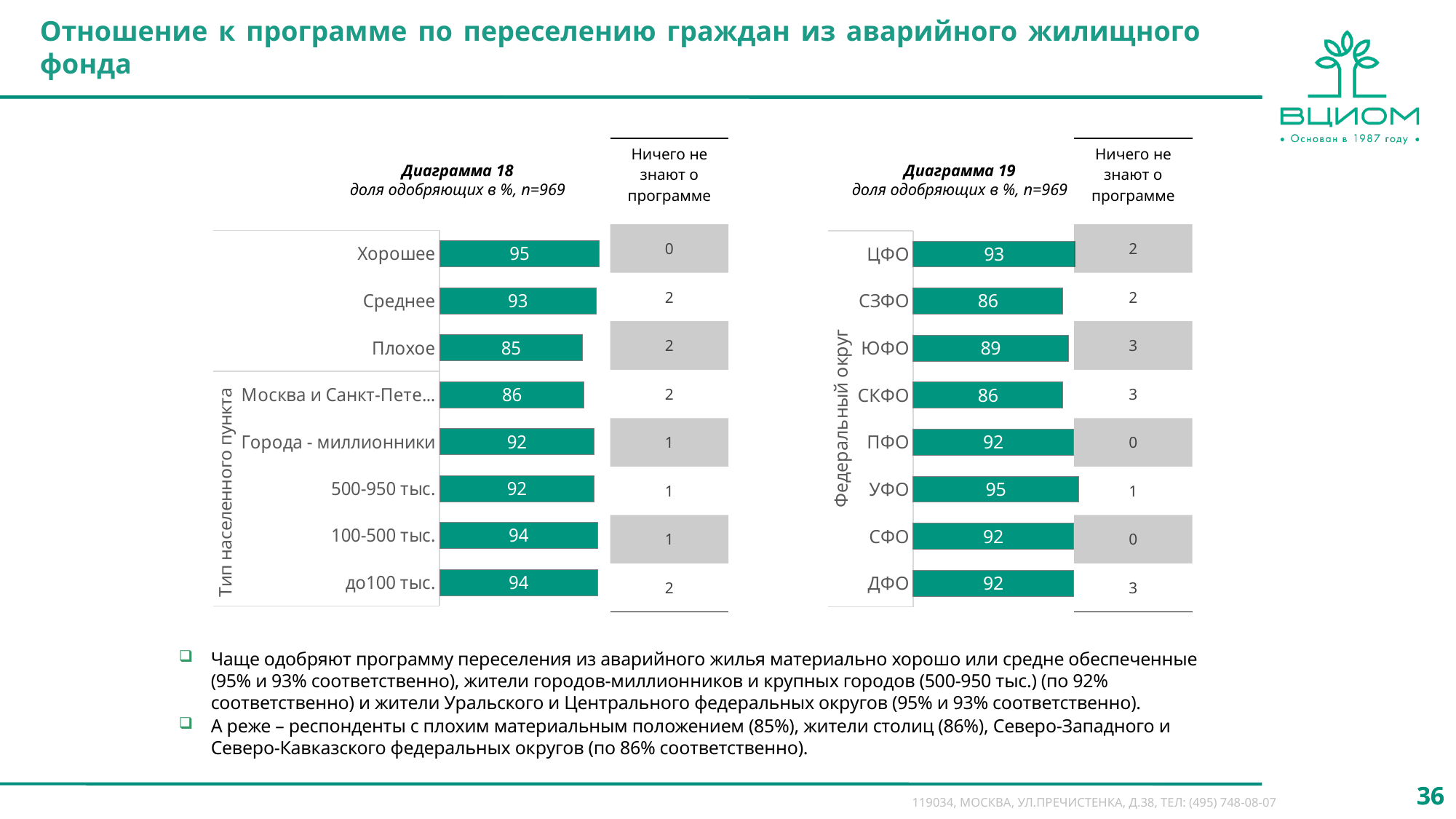
In Диаграмма 18, which is larger: the value for Города - миллионники or the value for 100-500 тыс.? 100-500 тыс. What type of chart is Диаграмма 19? Bar chart In Диаграмма 19, what is the value for ЮФО? 89 What is the subtitle shown under the title Диаграмма 18? доля одобряющих в %, n=969 In Диаграмма 18, what is the value for Хорошее? 95 In Диаграмма 19, what is the difference between the values for ЦФО and СЗФО? 7 In Диаграмма 18, which category has the lowest value? Плохое In Диаграмма 19, which federal district has the highest value? УФО In Диаграмма 18, how many categories are plotted? 8 In Диаграмма 18, what is the value for Плохое? 85 In Диаграмма 19, what is the value for УФО? 95 In Диаграмма 18, what is the difference between the values for Хорошее and Плохое? 10